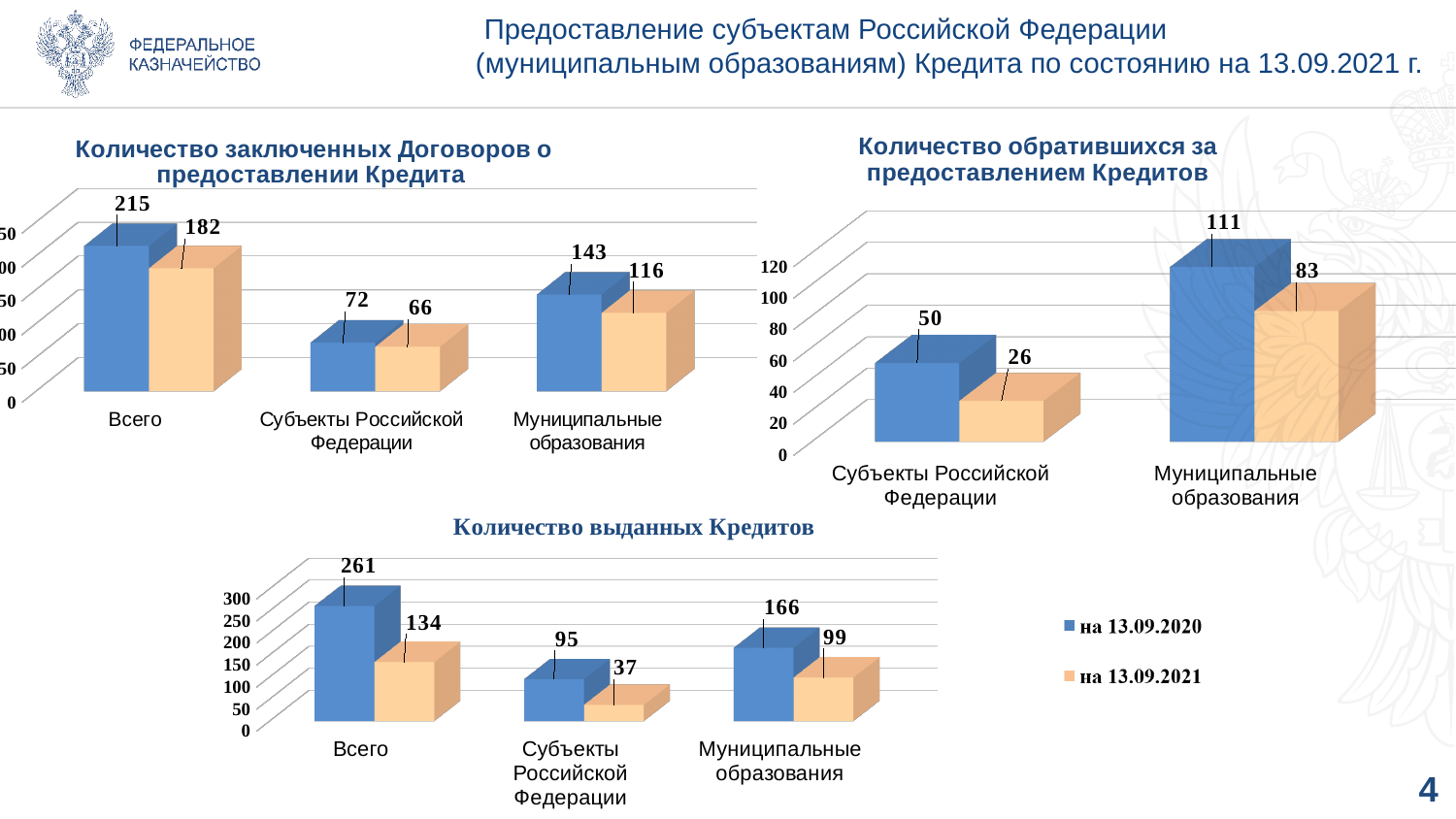
In the chart 'Количество заключенных Договоров о предоставлении Кредита', what is the value of the orange bar for 'Муниципальные образования'? 116 In the chart 'Количество выданных Кредитов', which is larger: the 'на 13.09.2021' value for 'Всего' or the 'на 13.09.2020' value for 'Муниципальные образования'? на 13.09.2020 value for Муниципальные образования In the chart 'Количество обратившихся за предоставлением Кредитов', what is the value of the orange bar for 'Субъекты Российской Федерации'? 26 In the chart 'Количество заключенных Договоров о предоставлении Кредита', what is the value of the blue bar for 'Всего'? 215 In the chart 'Количество обратившихся за предоставлением Кредитов', how many categories are shown on the x axis? 2 How many series does the legend on the slide list? 2 In the chart 'Количество выданных Кредитов', what is the value for 'Всего' in the series 'на 13.09.2021'? 134 In the chart 'Количество выданных Кредитов', what is the difference between the 'на 13.09.2020' and 'на 13.09.2021' values for 'Муниципальные образования'? 67 In the chart 'Количество обратившихся за предоставлением Кредитов', which category has the highest blue bar? Муниципальные образования In the chart 'Количество заключенных Договоров о предоставлении Кредита', what is the difference between the blue and orange bars for 'Субъекты Российской Федерации'? 6 In the chart 'Количество выданных Кредитов', what is the value for 'Субъекты Российской Федерации' in the series 'на 13.09.2020'? 95 In the chart 'Количество обратившихся за предоставлением Кредитов', what is the value of the blue bar for 'Муниципальные образования'? 111